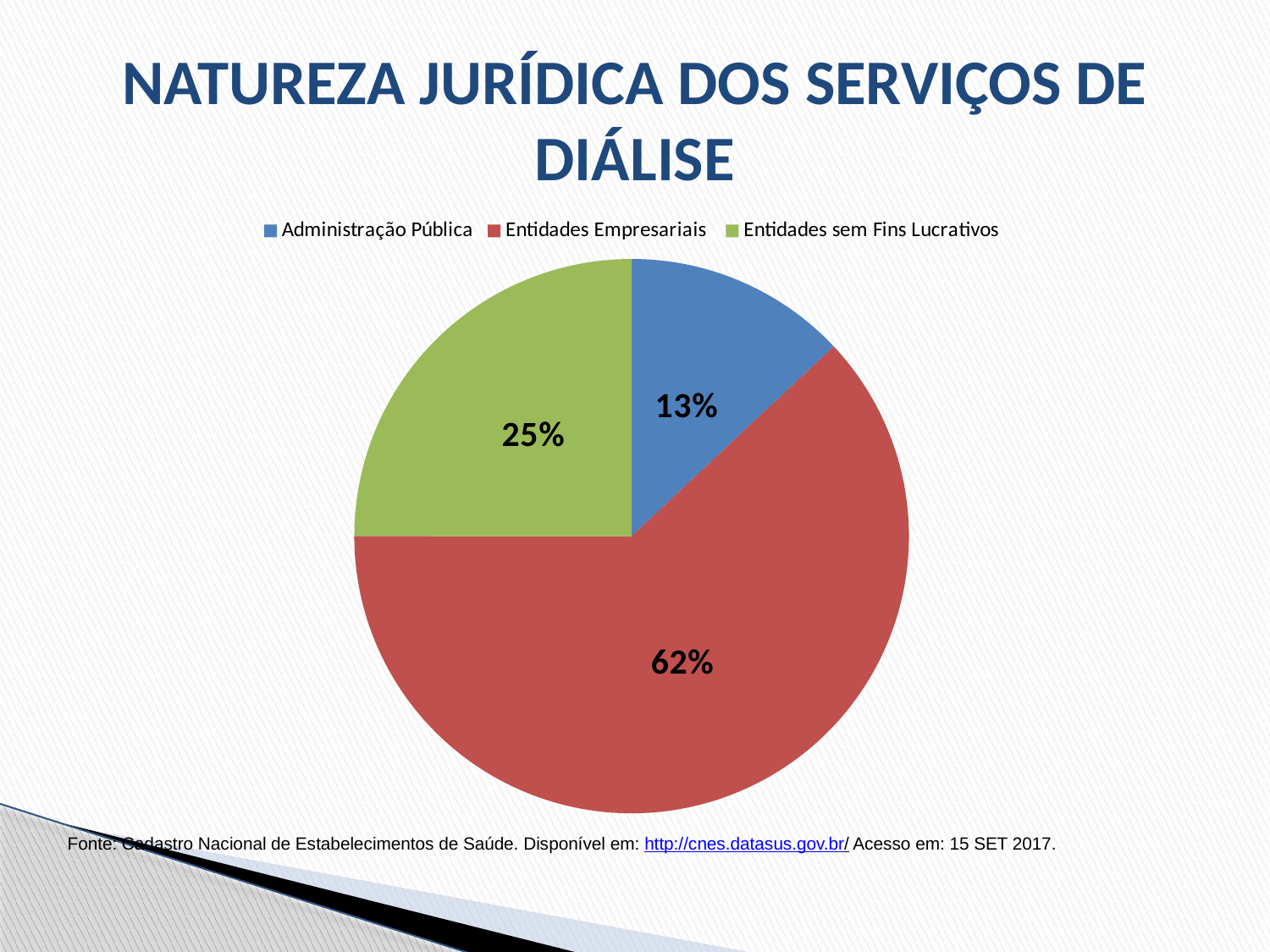
What is the title of the chart on the slide? NATUREZA JURÍDICA DOS SERVIÇOS DE DIÁLISE What kind of chart is shown on the slide? pie chart Which is larger, the slice for Administração Pública or the slice for Entidades sem Fins Lucrativos? Entidades sem Fins Lucrativos What share of the pie does Entidades Empresariais have? 62% What share of the pie does Entidades sem Fins Lucrativos have? 25% What is the difference in percentage points between Entidades sem Fins Lucrativos and Administração Pública? 12 Which category has the smallest slice of the pie? Administração Pública What colour is the slice for Entidades Empresariais? red Which category has the largest slice of the pie? Entidades Empresariais What share of the pie does Administração Pública have? 13% What is the difference in percentage points between Entidades Empresariais and Entidades sem Fins Lucrativos? 37 How many categories does the pie chart show? 3